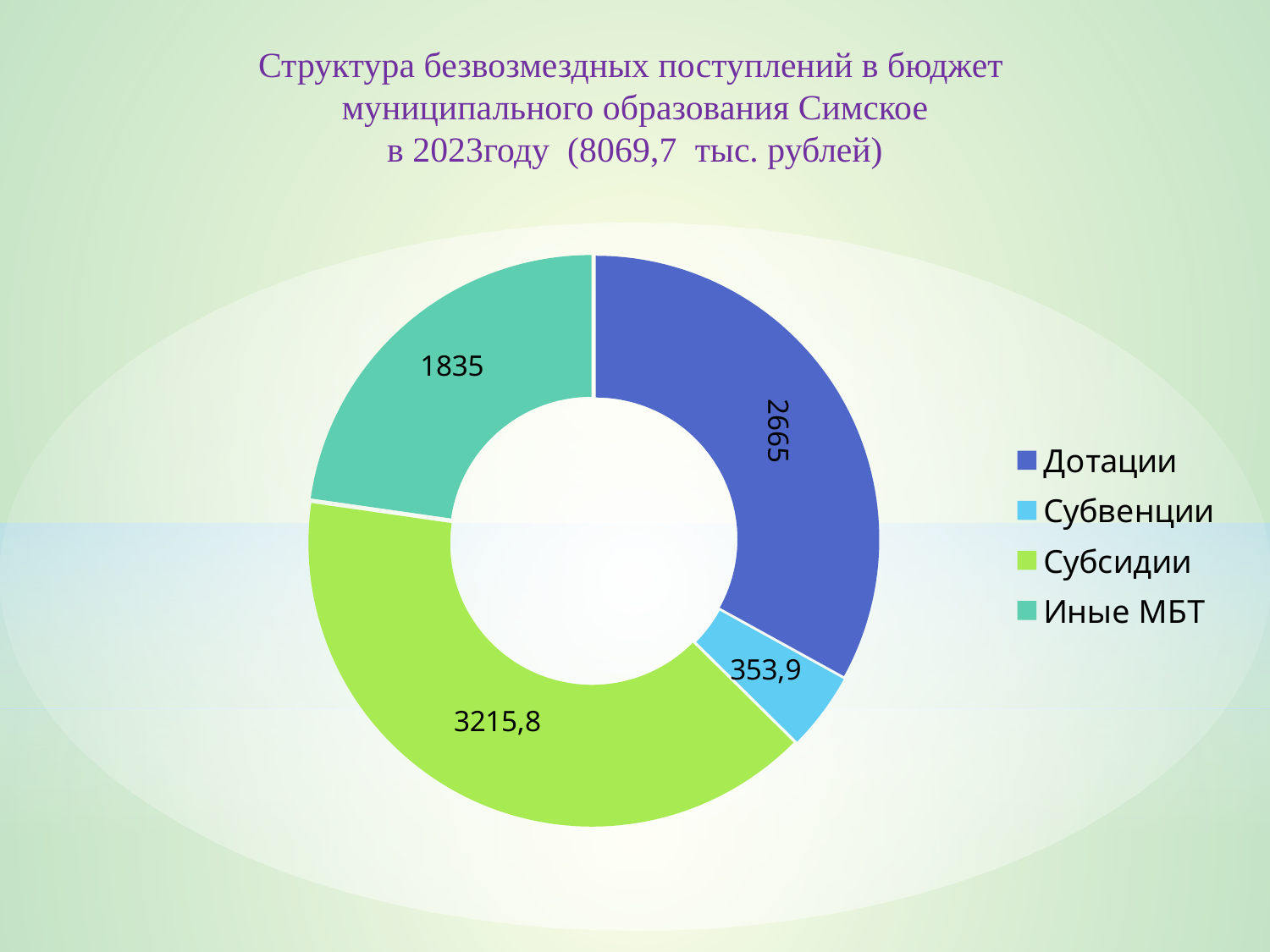
What is the value for Субвенции? 353,9 Which is larger, the value for Иные МБТ or the value for Субвенции? Иные МБТ What is the value for Субсидии? 3215,8 Which category has the smallest value? Субвенции What is the difference between the values for Дотации and Иные МБТ? 830 Which category has the largest value? Субсидии How many categories does the chart show? 4 What total amount in thousand rubles is stated in the chart title? 8069,7 What is the difference between the values for Субсидии and Дотации? 550,8 What kind of chart is shown on the slide? doughnut chart What is the value for Дотации? 2665 What is the value for Иные МБТ? 1835